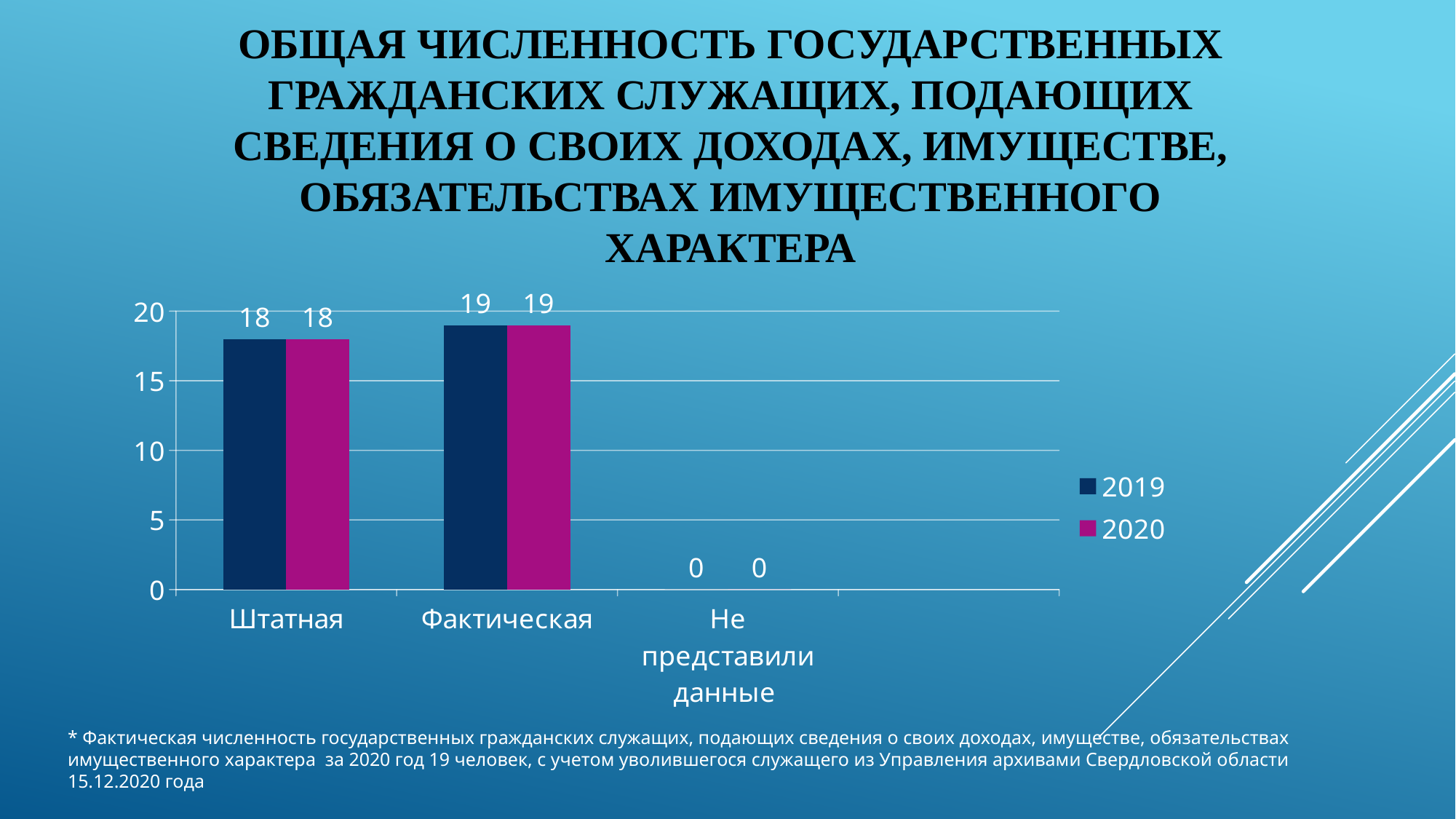
Which category has the highest value in the 2020 series? Фактическая Which category has the lowest value in the 2019 series? Не представили данные Which is larger in the 2020 series: Штатная or Фактическая? Фактическая How many series does the legend list? 2 What is the difference between the 2019 values for Фактическая and Штатная? 1 What kind of chart is shown on the slide? bar chart What is the value for Штатная in the 2019 series? 18 What is the value for Не представили данные in the 2019 series? 0 Which series is shown in magenta in the legend? 2020 What is the value for Фактическая in the 2020 series? 19 Is the 2019 value for Штатная greater or less than 15? greater How many categories are shown on the x axis? 3